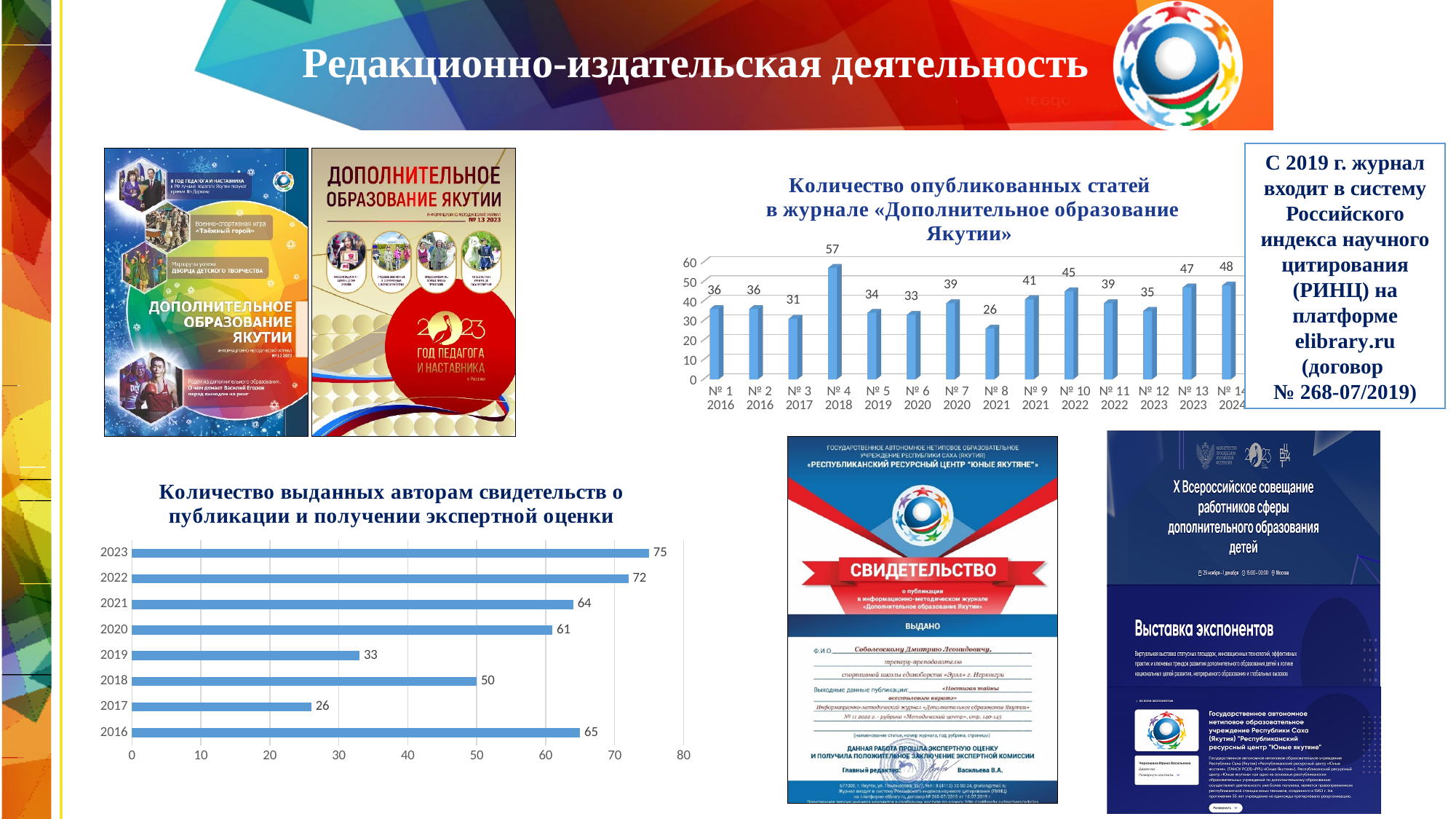
In the chart "Количество опубликованных статей в журнале «Дополнительное образование Якутии»", which issue has the highest number of articles? № 4 2018 In the chart "Количество опубликованных статей в журнале «Дополнительное образование Якутии»", which issue has the lowest number of articles? № 8 2021 In the chart "Количество опубликованных статей в журнале «Дополнительное образование Якутии»", what is the difference between the values for issue № 14 (2024) and issue № 12 (2023)? 13 In the chart "Количество выданных авторам свидетельств о публикации и получении экспертной оценки", which year has the highest value? 2023 In the chart "Количество опубликованных статей в журнале «Дополнительное образование Якутии»", how many articles were published in issue № 4 (2018)? 57 What type of chart is "Количество выданных авторам свидетельств о публикации и получении экспертной оценки"? Bar chart In the chart "Количество опубликованных статей в журнале «Дополнительное образование Якутии»", which has more articles: issue № 10 (2022) or issue № 11 (2022)? № 10 2022 In the chart "Количество опубликованных статей в журнале «Дополнительное образование Якутии»", how many issues are shown on the x axis? 14 In the chart "Количество выданных авторам свидетельств о публикации и получении экспертной оценки", how many years are shown? 8 In the chart "Количество выданных авторам свидетельств о публикации и получении экспертной оценки", what is the difference between the values for 2016 and 2019? 32 In the chart "Количество выданных авторам свидетельств о публикации и получении экспертной оценки", which year has the lowest value? 2017 In the chart "Количество выданных авторам свидетельств о публикации и получении экспертной оценки", what is the value for 2023? 75